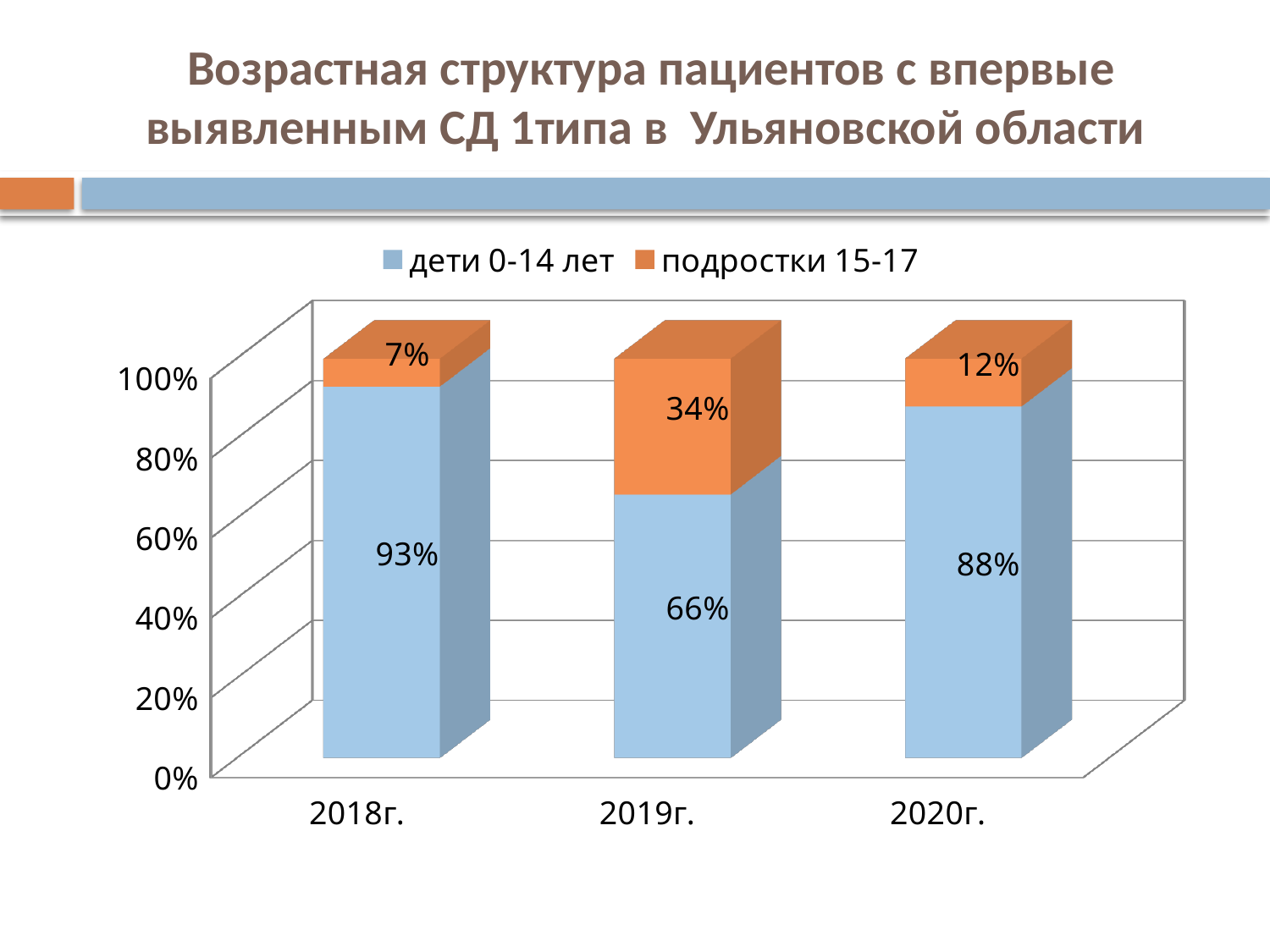
What is the difference between the дети 0-14 лет values for 2018г. and 2019г.? 27% What is the value for дети 0-14 лет in 2018г.? 93% What kind of chart is shown on the slide? Stacked bar chart How many series does the legend list? 2 What is the value for подростки 15-17 in 2019г.? 34% How many years are shown on the x axis? 3 Which colour represents подростки 15-17 in the chart? Orange Which is larger: подростки 15-17 in 2020г. or подростки 15-17 in 2018г.? подростки 15-17 in 2020г. What is the value for подростки 15-17 in 2018г.? 7% In which year is the share of дети 0-14 лет the lowest? 2019г. What is the value for дети 0-14 лет in 2020г.? 88% In which year is the share of подростки 15-17 the highest? 2019г.